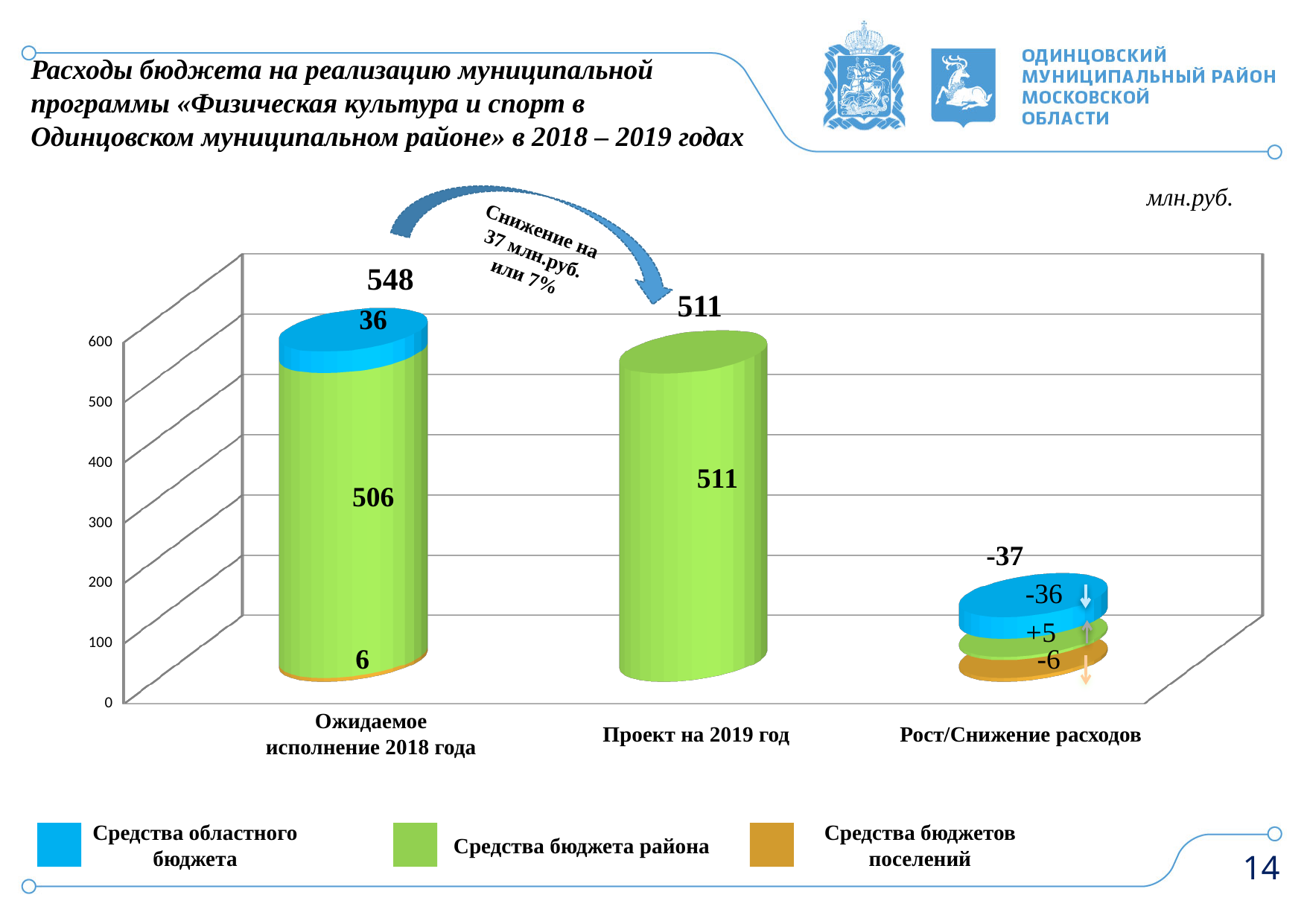
What is the total value shown for «Рост/Снижение расходов»? -37 What is the difference between the total for «Ожидаемое исполнение 2018 года» and the value for «Проект на 2019 год»? 37 What is the value for «Средства областного бюджета» in «Ожидаемое исполнение 2018 года»? 36 What is the total value shown above the bar for «Ожидаемое исполнение 2018 года»? 548 How many series does the legend list? 3 Which is larger: the total for «Ожидаемое исполнение 2018 года» or the value for «Проект на 2019 год»? Ожидаемое исполнение 2018 года What is the value for «Средства областного бюджета» in «Рост/Снижение расходов»? -36 What is the value for «Проект на 2019 год»? 511 What is the value for «Средства бюджетов поселений» in «Ожидаемое исполнение 2018 года»? 6 What unit of measurement is indicated on the chart? млн.руб. What is the value for «Средства бюджета района» in «Ожидаемое исполнение 2018 года»? 506 What is the value for «Средства бюджета района» in «Рост/Снижение расходов»? +5